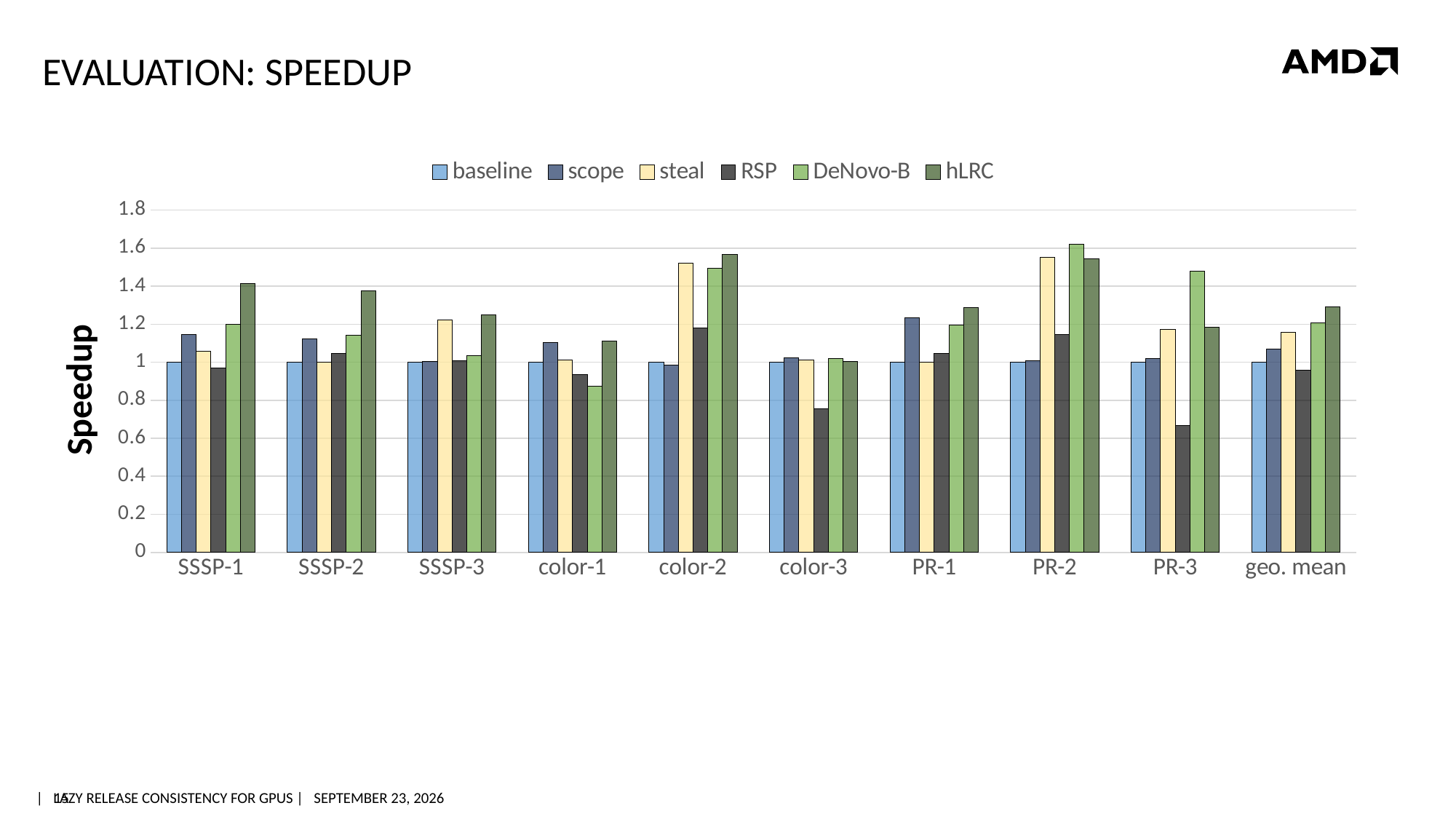
Which series has the lowest speedup for PR-3? RSP What is the label on the y axis? Speedup What is the speedup value for the baseline series in SSSP-1? 1 How many series does the legend list? 6 What kind of chart is shown on the slide? bar chart Is the value for steal in color-2 greater or less than 1.4? greater For PR-1, which is larger: the value for scope or the value for steal? scope How many categories are shown along the x axis? 10 Which series has the highest speedup for SSSP-1? hLRC Is the value for RSP in PR-3 greater or less than 0.8? less Is the value for DeNovo-B in color-1 greater or less than 1? less Which series has the highest speedup for PR-2? DeNovo-B